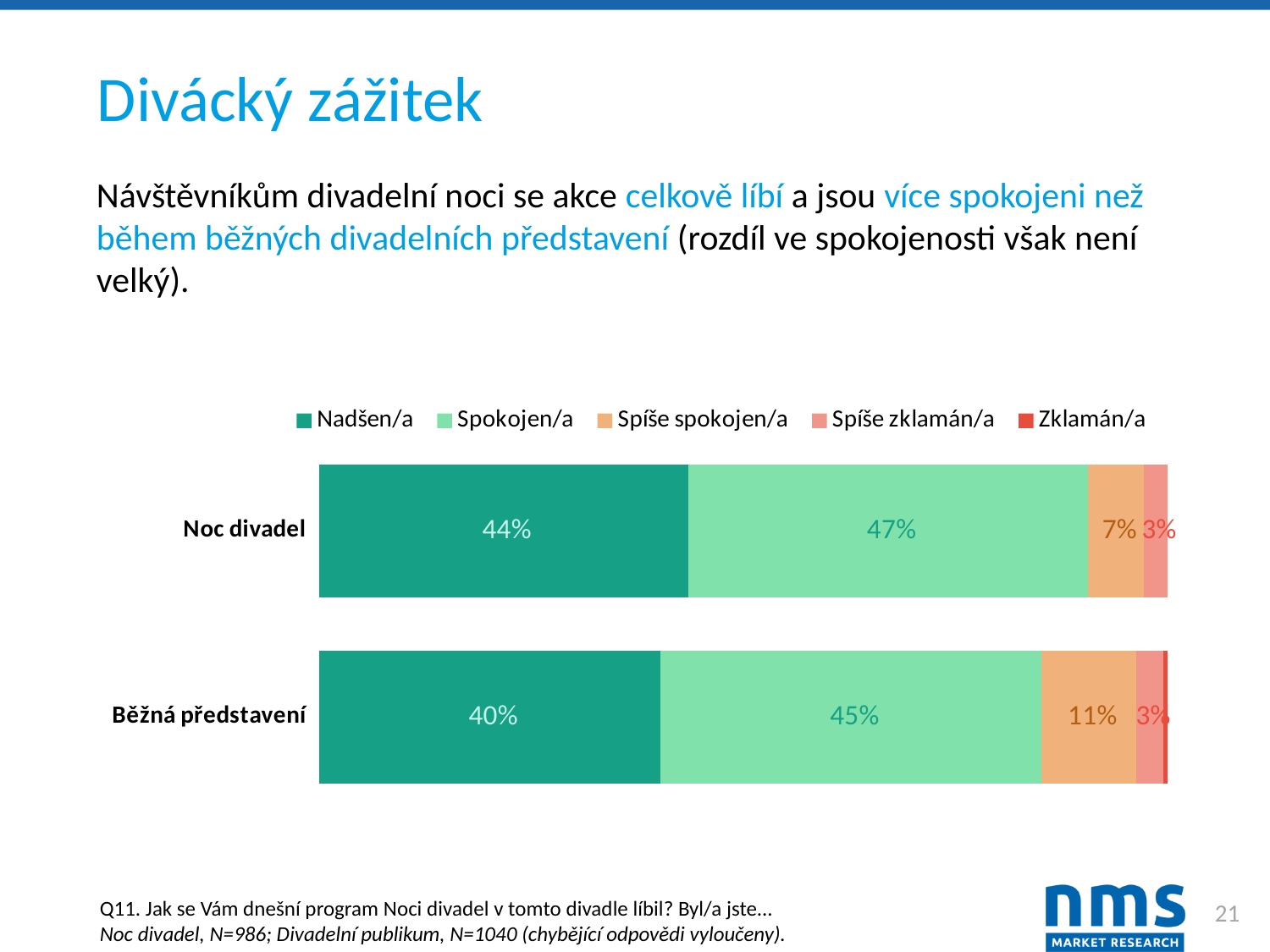
What percentage of Noc divadel respondents answered Nadšen/a? 44% What percentage of Běžná představení respondents answered Spokojen/a? 45% What kind of chart is shown on the slide? Stacked bar chart What is the difference in percentage points between the Nadšen/a values for Noc divadel and Běžná představení? 4 percentage points What is the Spíše spokojen/a value for Běžná představení? 11% Which category has the higher Nadšen/a share, Noc divadel or Běžná představení? Noc divadel How many series does the legend list? 5 What is the difference in percentage points between the Spokojen/a values for Noc divadel and Běžná představení? 2 percentage points What is the Spíše zklamán/a value for Noc divadel? 3% Which category has the higher Spíše spokojen/a share, Noc divadel or Běžná představení? Běžná představení How many categories (bars) does the chart show? 2 What is the Spíše spokojen/a value for Noc divadel? 7%